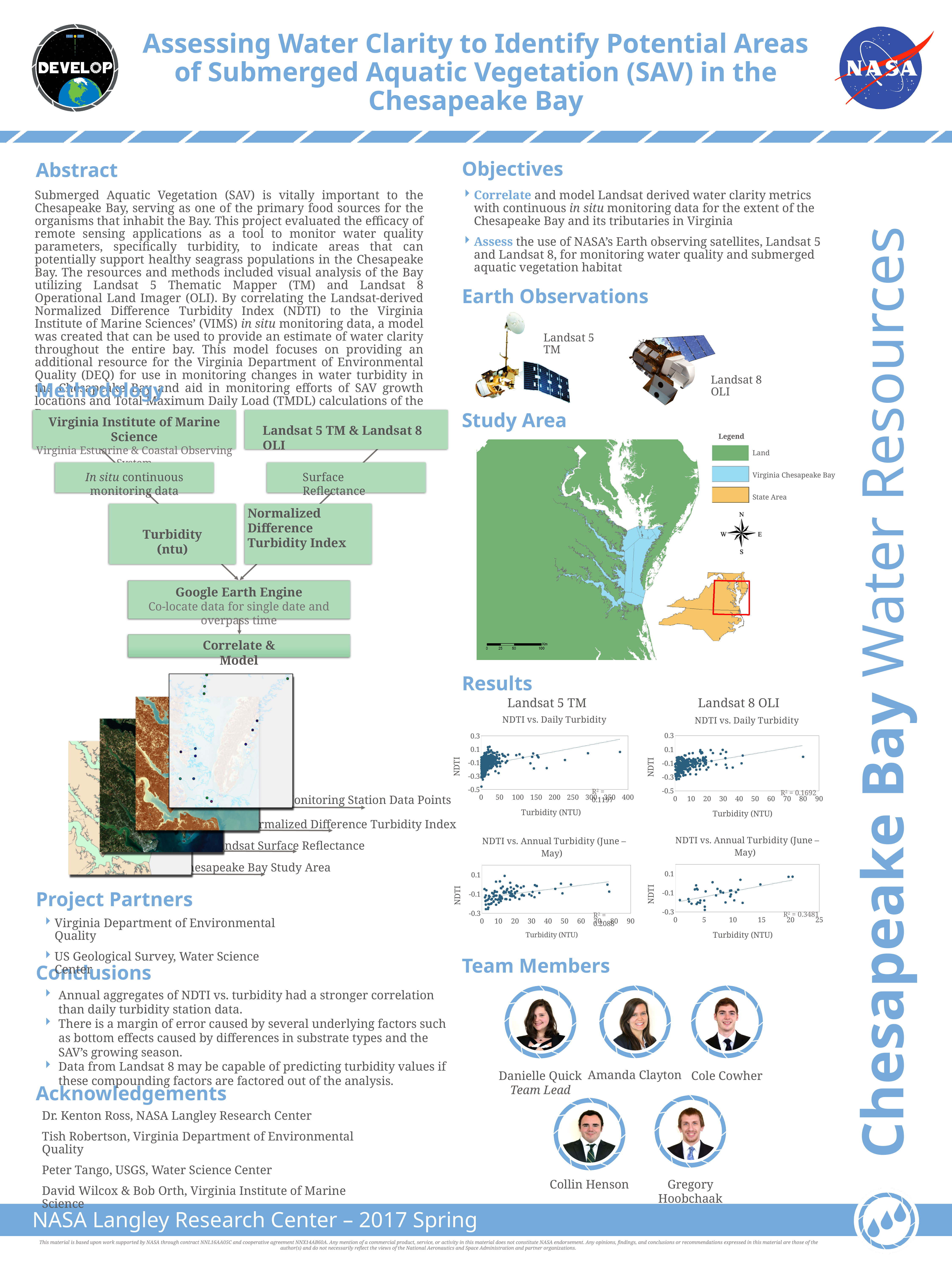
How many charts are shown in the Results section? 4 In the Landsat 5 TM 'NDTI vs. Daily Turbidity' chart, what is the highest value shown on the x axis? 400 What is the x-axis label on the Landsat 8 OLI 'NDTI vs. Daily Turbidity' chart? Turbidity (NTU) In the Landsat 5 TM 'NDTI vs. Annual Turbidity (June – May)' chart, does the trend line rise or fall along the x axis? Rises Is the R² value printed on the Landsat 8 OLI 'NDTI vs. Annual Turbidity' chart larger or smaller than the R² on the Landsat 8 OLI 'NDTI vs. Daily Turbidity' chart? Larger In the Landsat 8 OLI 'NDTI vs. Annual Turbidity (June – May)' chart, does the fitted trend line rise or fall as Turbidity (NTU) increases? Rises Which of the four Results charts shows the highest printed R² value? Landsat 8 OLI, NDTI vs. Annual Turbidity (June – May) In the Landsat 8 OLI 'NDTI vs. Daily Turbidity' chart, what R² value is printed? R² = 0.1692 In the Landsat 5 TM 'NDTI vs. Annual Turbidity (June – May)' chart, what R² value is printed? R² = 0.2088 In the Landsat 8 OLI 'NDTI vs. Annual Turbidity (June – May)' chart, what R² value is printed? R² = 0.3481 What kind of chart is the Landsat 5 TM 'NDTI vs. Daily Turbidity' chart in the Results section? Scatter chart